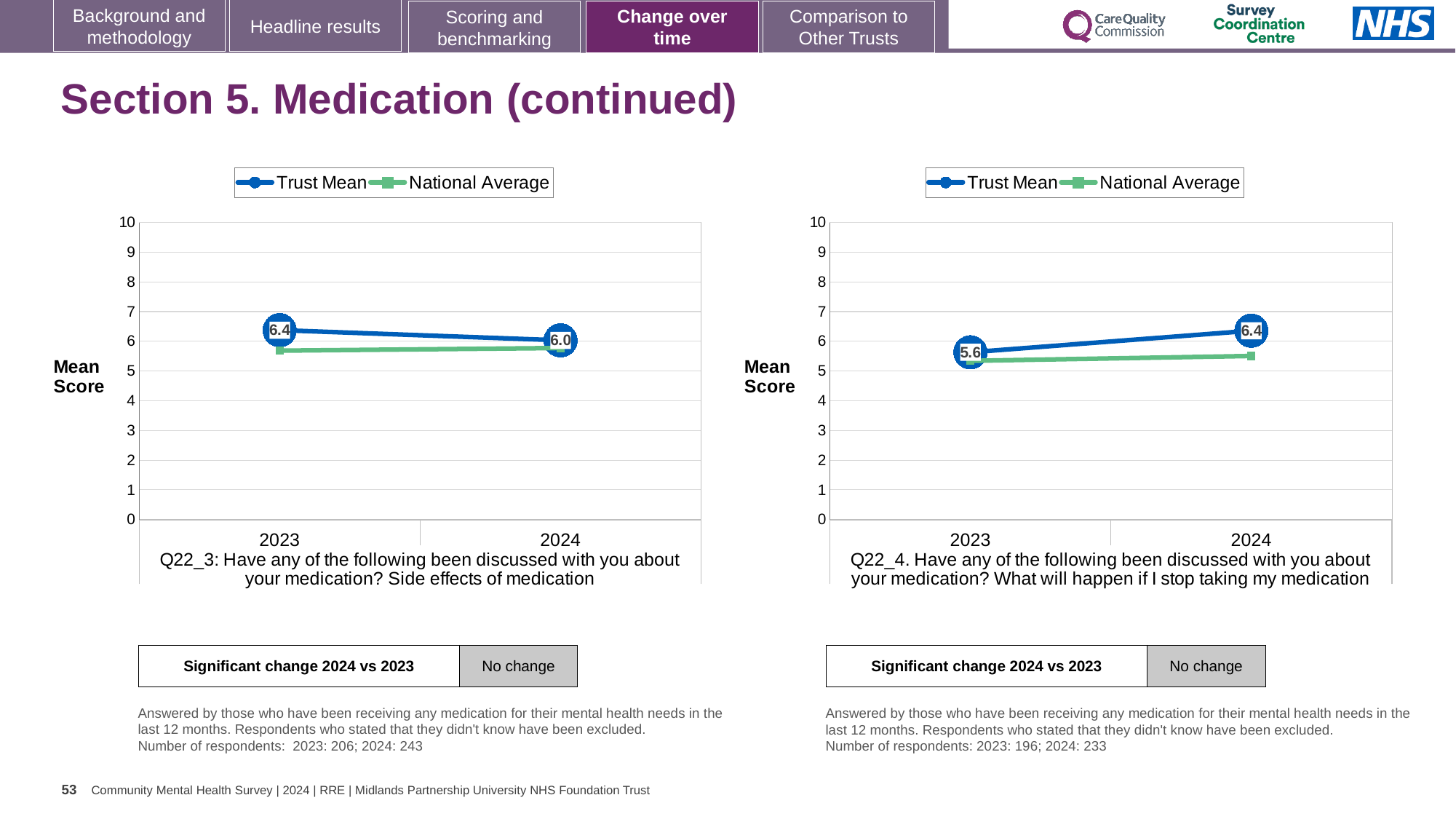
In the Q22_4 chart (right), what is the difference between the Trust Mean in 2024 and in 2023? 0.8 In the Q22_3 chart (left), what is the Trust Mean for 2023? 6.4 In the Q22_4 chart (right), what is the Trust Mean for 2024? 6.4 In the Q22_3 chart (left), by how much did the Trust Mean change from 2023 to 2024? 0.4 In the Q22_3 chart (left), which series has the higher value in 2023, Trust Mean or National Average? Trust Mean In the Q22_3 chart (left), what is the Trust Mean for 2024? 6.0 In the Q22_4 chart (right), is the National Average for 2023 greater or less than 6? less How many series does the legend of the Q22_4 chart (right) list? 2 In the Q22_3 chart (left), does the Trust Mean rise or fall from 2023 to 2024? fall In the Q22_4 chart (right), what is the Trust Mean for 2023? 5.6 What kind of chart is the Q22_3 chart on the left? line chart In the Q22_4 chart (right), does the Trust Mean rise or fall from 2023 to 2024? rise